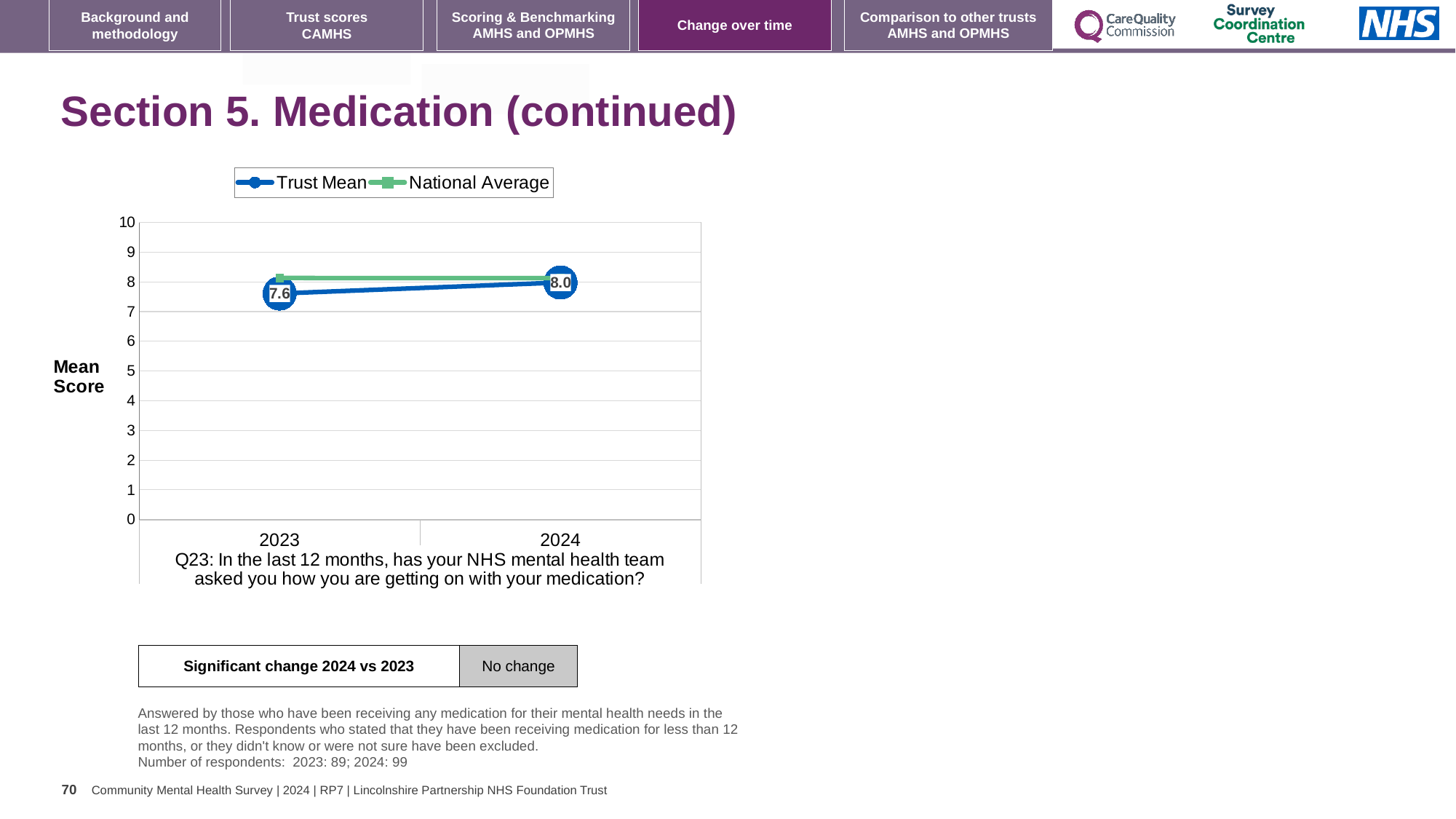
How many series does the chart legend list? 2 Is the National Average value for 2023 greater or less than 7? greater In which year is the Trust Mean score higher, 2023 or 2024? 2024 Does the Trust Mean rise or fall from 2023 to 2024? Rise How many years are shown on the x axis of the chart? 2 Is the Trust Mean value for 2023 greater or less than 8? less Which is larger in 2023, the Trust Mean or the National Average? National Average In which year is the Trust Mean score lowest? 2023 What is the Trust Mean score for 2024? 8.0 What kind of chart is shown on the slide? Line chart What is the Trust Mean score for 2023? 7.6 By how much did the Trust Mean score change from 2023 to 2024? 0.4